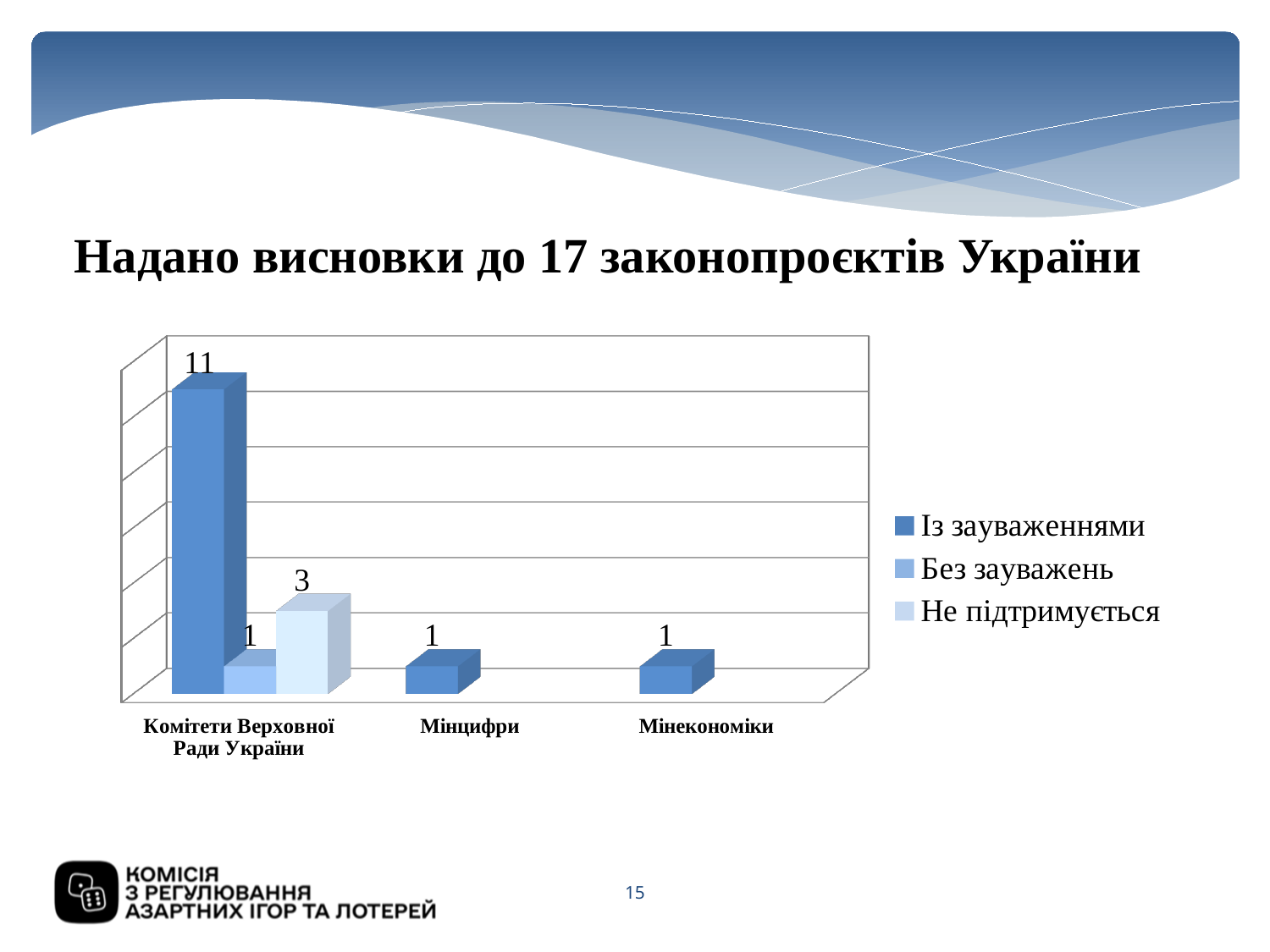
What is the value of "Із зауваженнями" for "Комітети Верховної Ради України"? 11 How many categories are shown on the x axis? 3 What is the value of "Без зауважень" for "Комітети Верховної Ради України"? 1 How many series does the legend list? 3 Which is larger for "Комітети Верховної Ради України": "Без зауважень" or "Не підтримується"? Не підтримується What is the difference between "Із зауваженнями" and "Не підтримується" for "Комітети Верховної Ради України"? 8 What is the value of "Не підтримується" for "Комітети Верховної Ради України"? 3 What type of chart is shown on the slide? bar chart What is the value of "Із зауваженнями" for "Мінцифри"? 1 What is the title of the slide above the chart? Надано висновки до 17 законопроєктів України Which legend entry is shown in the lightest blue colour? Не підтримується Which category has the highest value for "Із зауваженнями"? Комітети Верховної Ради України